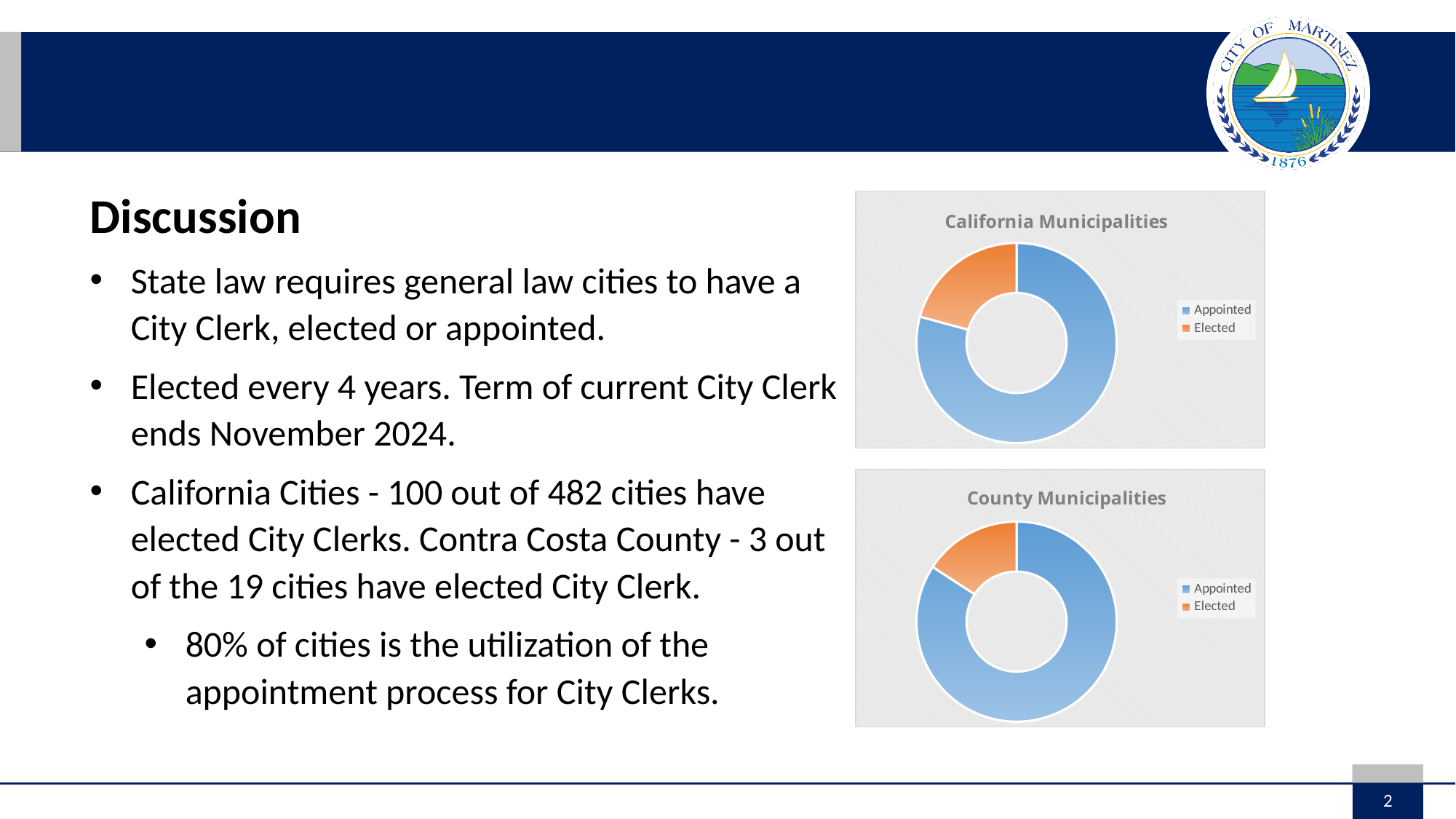
In the County Municipalities chart, what colour represents the Elected category? Orange In the County Municipalities chart, which category has the largest share? Appointed What kind of chart is the California Municipalities chart? Doughnut chart In the California Municipalities chart, which category has the smallest share? Elected How many categories does the legend of the County Municipalities chart list? 2 How many categories does the legend of the California Municipalities chart list? 2 What is the title of the top chart on the slide? California Municipalities In the County Municipalities chart, is the Appointed share larger or smaller than the Elected share? Larger In the County Municipalities chart, which category has the smallest share? Elected In the California Municipalities chart, which category has the largest share? Appointed What kind of chart is the County Municipalities chart? Doughnut chart